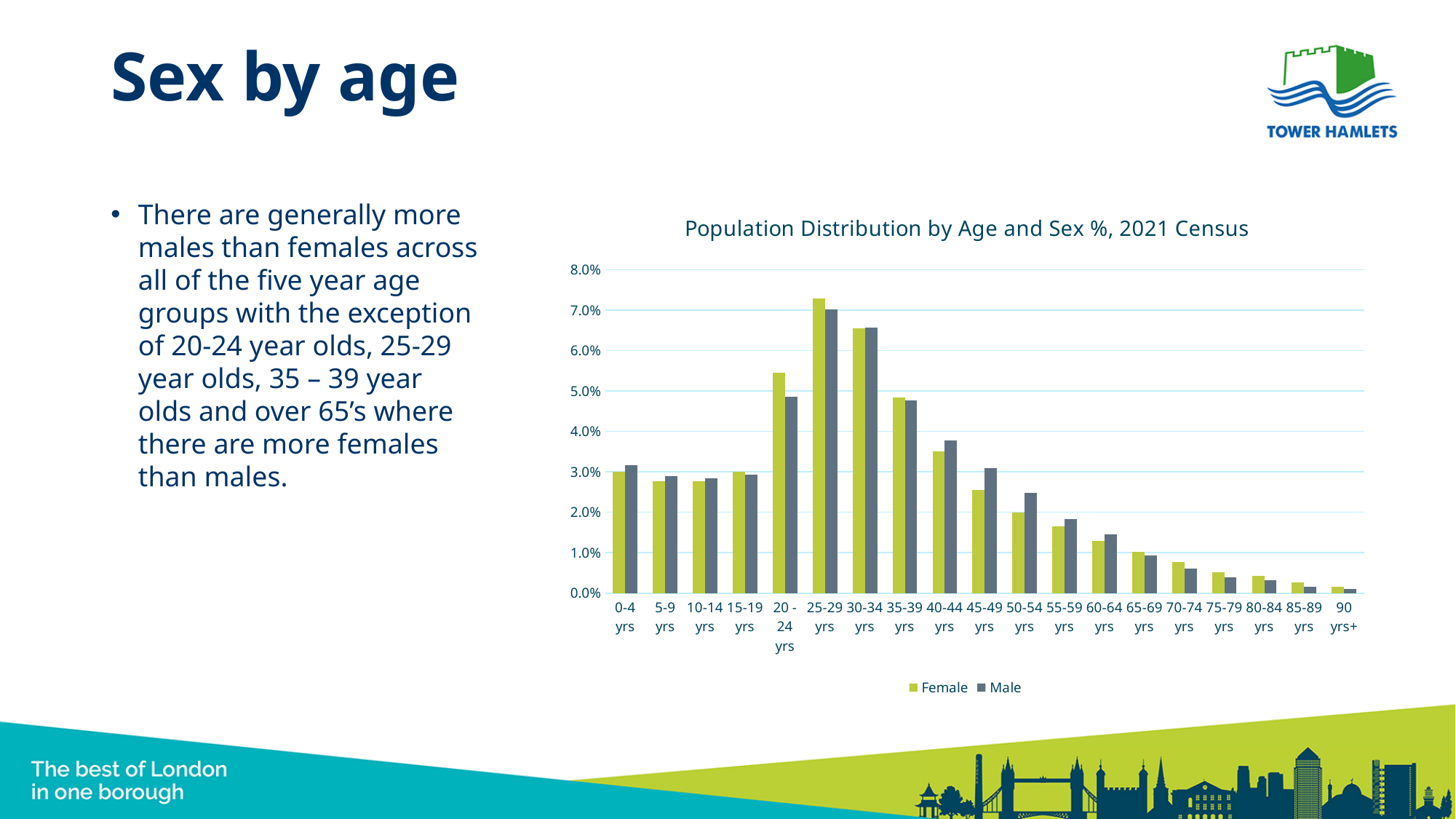
Do the Female values rise or fall along the x axis from 25-29 yrs to 90 yrs+? fall Which age group has the highest Female value? 25-29 yrs Is the Female value for 20-24 yrs greater or less than 5.0%? greater Is the Male value for 20-24 yrs greater or less than 5.0%? less What is the title of the chart? Population Distribution by Age and Sex %, 2021 Census Which age group has the lowest Female value? 90 yrs+ Which age group has the highest Male value? 25-29 yrs What kind of chart is shown on the slide? Bar chart For the 40-44 yrs age group, which is larger, the Female or the Male value? Male How many age groups are shown on the x axis of the chart? 19 Is the Male value for 65-69 yrs greater or less than 1.0%? less How many series does the chart's legend list? 2